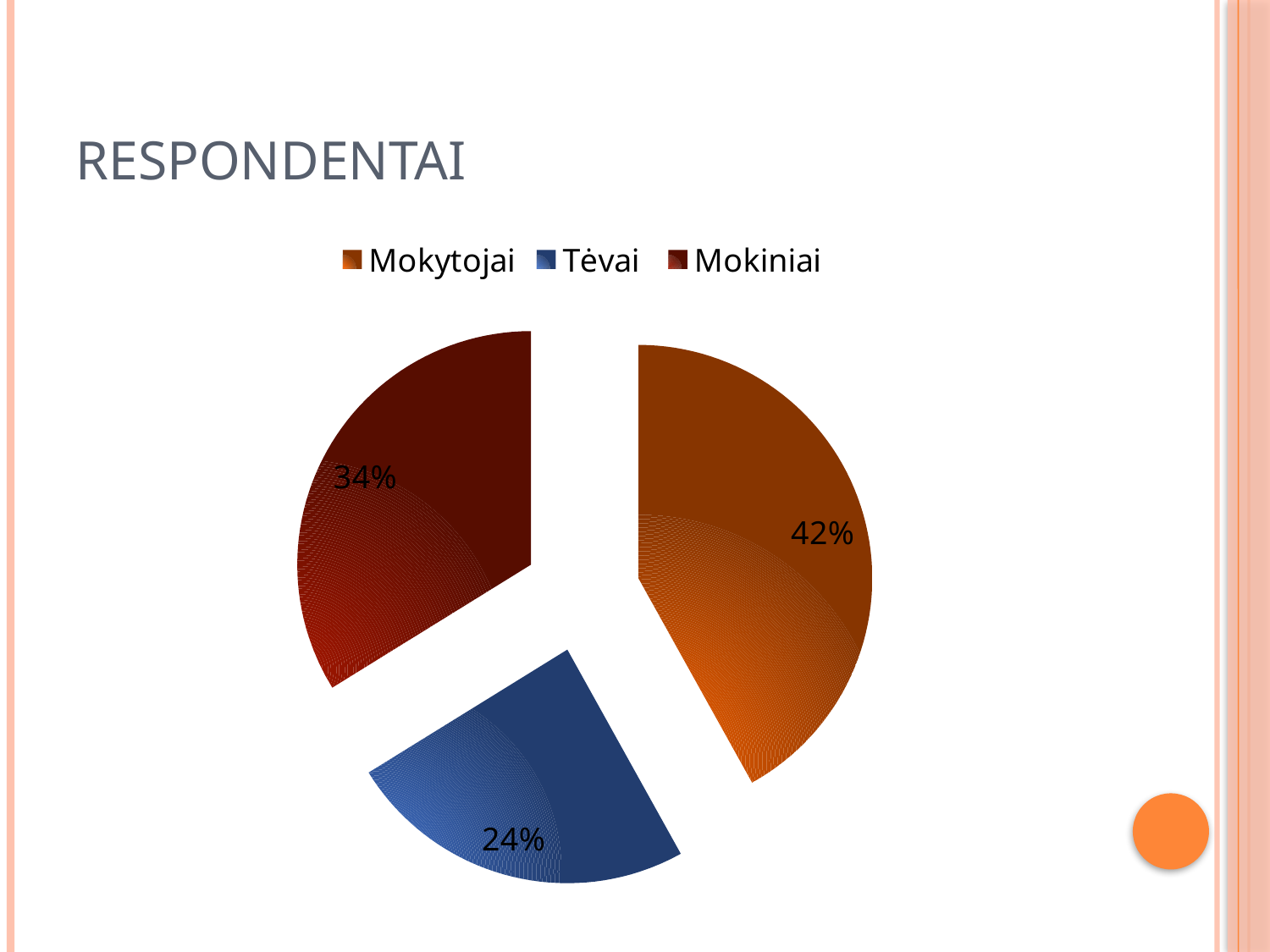
How many slices does the pie chart have? 3 Which group has the largest share of the pie? Mokytojai Which is larger, the share for Mokiniai or the share for Tėvai? Mokiniai What share of respondents are Mokytojai? 42% Which group has the smallest share of the pie? Tėvai What share of respondents are Tėvai? 24% What is the title of the slide containing the chart? RESPONDENTAI What is the difference in percentage points between Mokytojai and Tėvai? 18 What share of respondents are Mokiniai? 34% What is the difference in percentage points between Mokytojai and Mokiniai? 8 How many entries does the legend list? 3 What kind of chart is shown on the slide? pie chart